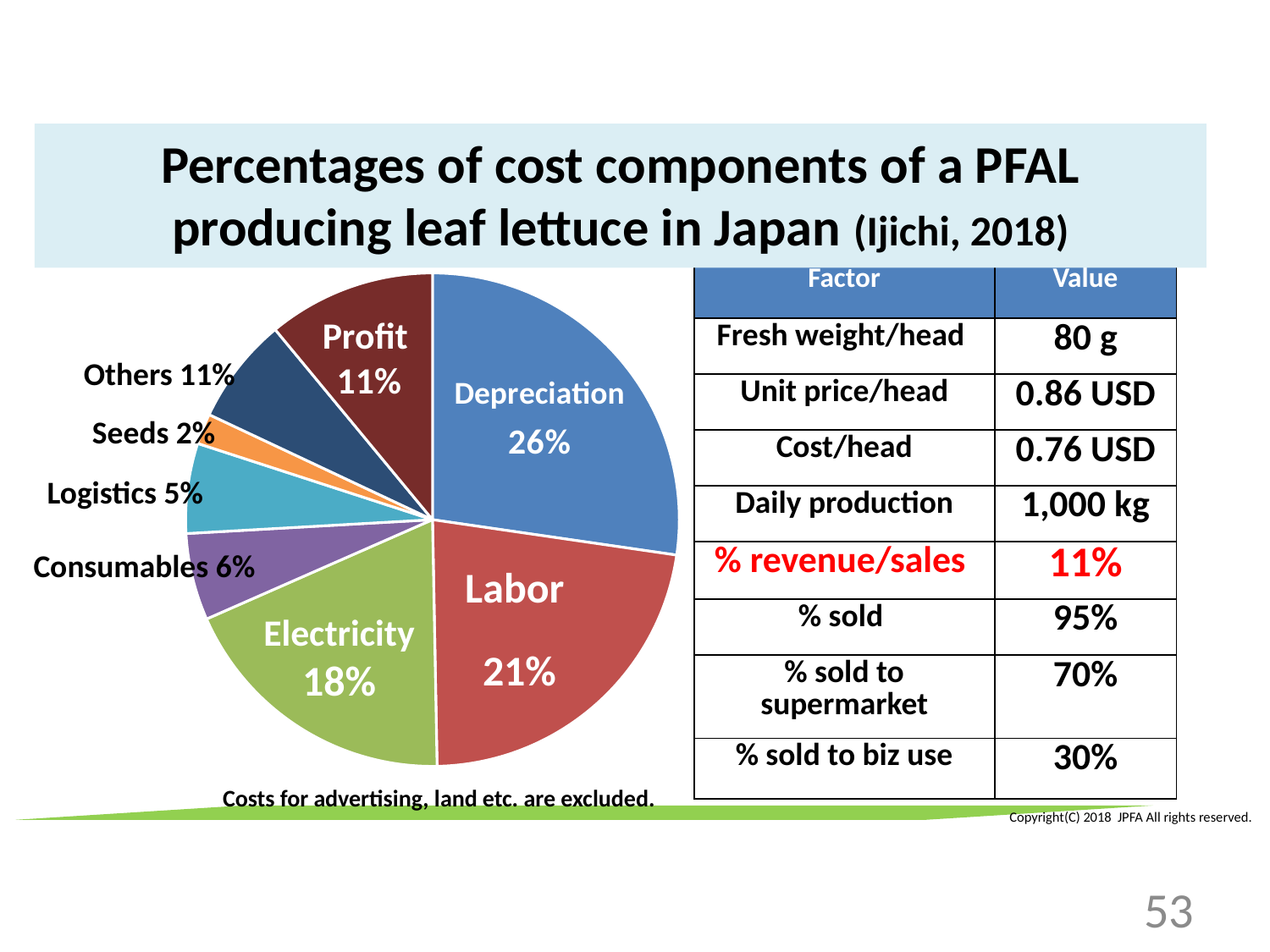
What percentage is shown for Logistics? 5% How many slices does the pie chart have? 8 What type of chart is shown on the slide? Pie chart What is the value shown for Electricity in the pie chart? 18% What is the difference in percentage points between Depreciation and Labor? 5 Which cost component has the largest share of the pie chart? Depreciation What percentage does Labor account for in the pie chart? 21% What percentage of the pie chart is Depreciation? 26% Which is larger, the share for Consumables or the share for Logistics? Consumables Which slice of the pie chart is the smallest? Seeds What is the difference in percentage points between Electricity and Consumables? 12 What is the title of the chart on the slide? Percentages of cost components of a PFAL producing leaf lettuce in Japan (Ijichi, 2018)